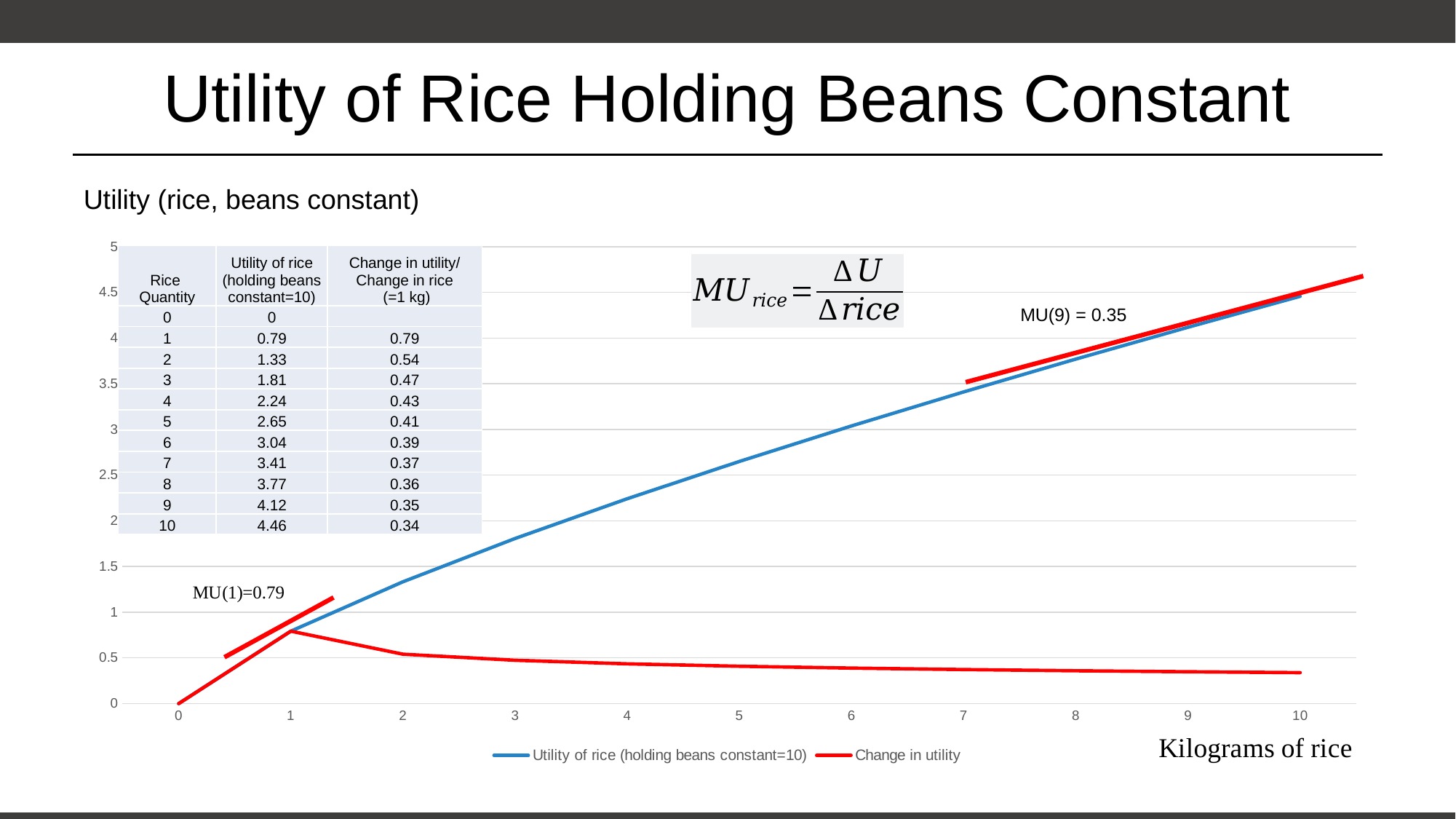
How many series does the chart legend list? 2 What is the difference in utility of rice between 9 kg and 8 kg of rice? 0.35 What is the utility of rice at a rice quantity of 5 kg? 2.65 What is the utility of rice at 10 kg of rice? 4.46 Does the utility of rice series rise or fall as kilograms of rice increase? rise Which is larger: the change in utility at 2 kg or at 7 kg of rice? 2 kg Is the utility of rice at 7 kg greater or less than 3? greater What is the label on the x axis of the chart? Kilograms of rice What is the change in utility at a rice quantity of 3 kg? 0.47 What kind of chart is shown on the slide? line chart At which rice quantity is the change in utility highest? 1